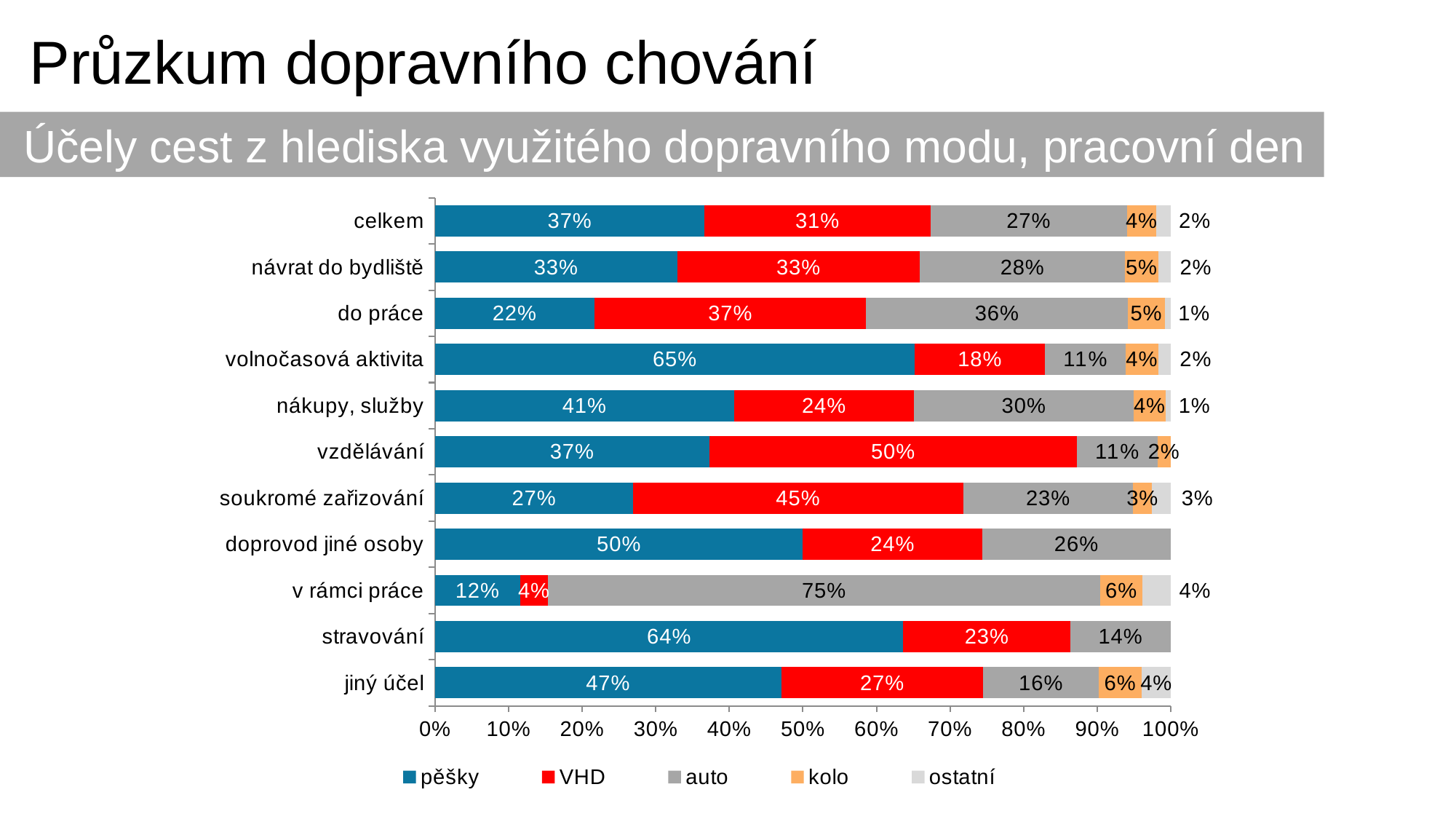
What is the value of pěšky for the category 'do práce'? 22% What is the difference between the pěšky value for 'volnočasová aktivita' and the pěšky value for 'celkem'? 28% Which is larger: the auto value for 'do práce' or the auto value for 'nákupy, služby'? do práce What is the value of kolo for the category 'jiný účel'? 6% How many series does the legend list? 5 How many categories are plotted on the chart? 11 What is the value of auto for the category 'v rámci práce'? 75% Which category has the lowest value for pěšky? v rámci práce What kind of chart is shown on the slide? stacked bar chart Which category has the highest value for VHD? vzdělávání Which series is shown in red in the legend? VHD What is the value of VHD for the category 'vzdělávání'? 50%